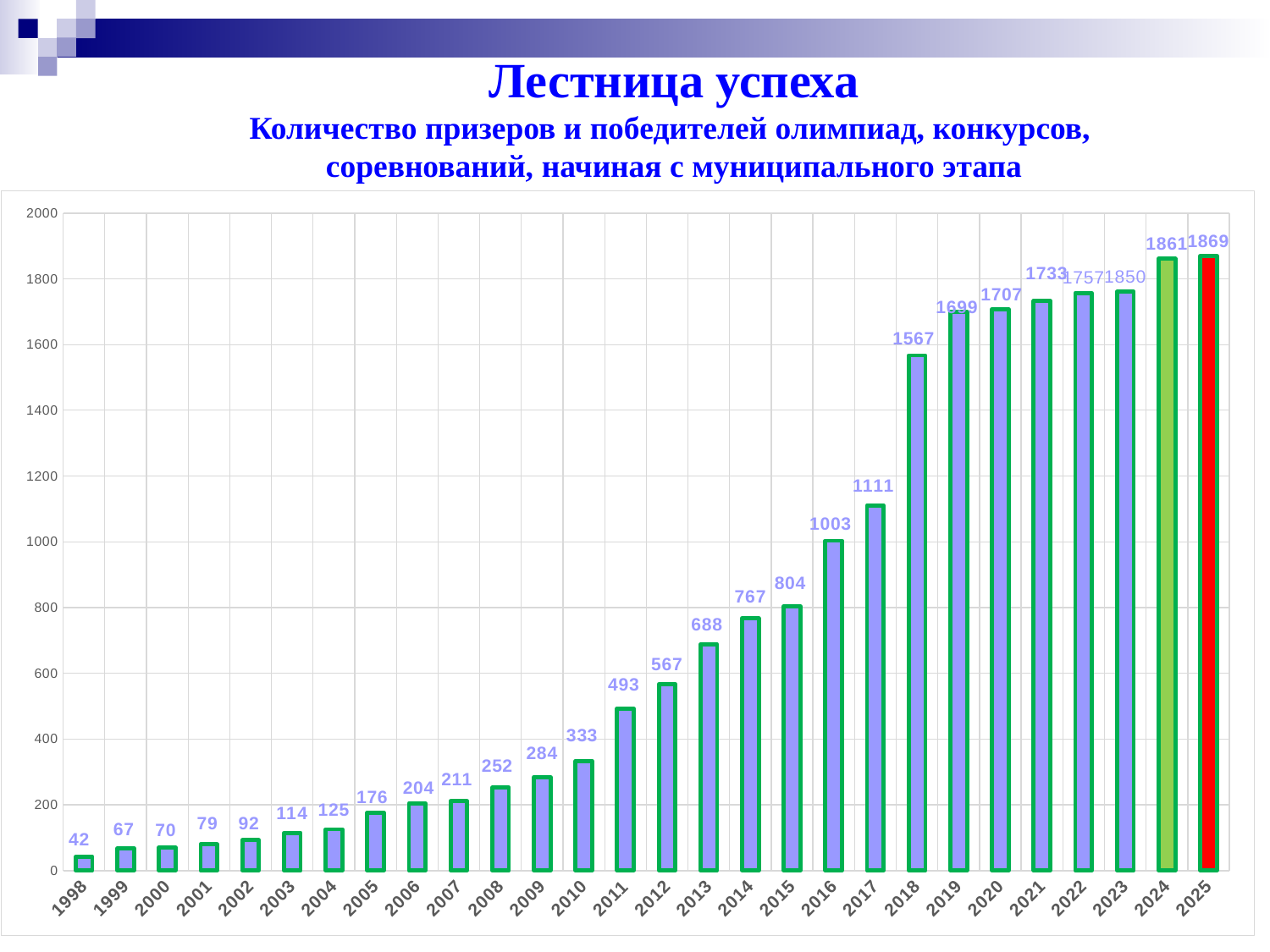
Do the values rise or fall from 1998 to 2025? rise What is the difference between the values for 2018 and 2017? 456 Which year has the lowest value? 1998 What is the value for 2010? 333 What type of chart is shown on the slide? bar chart Which year has the highest value? 2025 What is the value for 2016? 1003 Which is larger, the value for 2014 or the value for 2015? 2015 How many years are shown on the x axis? 28 Is the value for 2019 greater or less than 1600? greater What is the value for 2025? 1869 What is the value for 1998? 42